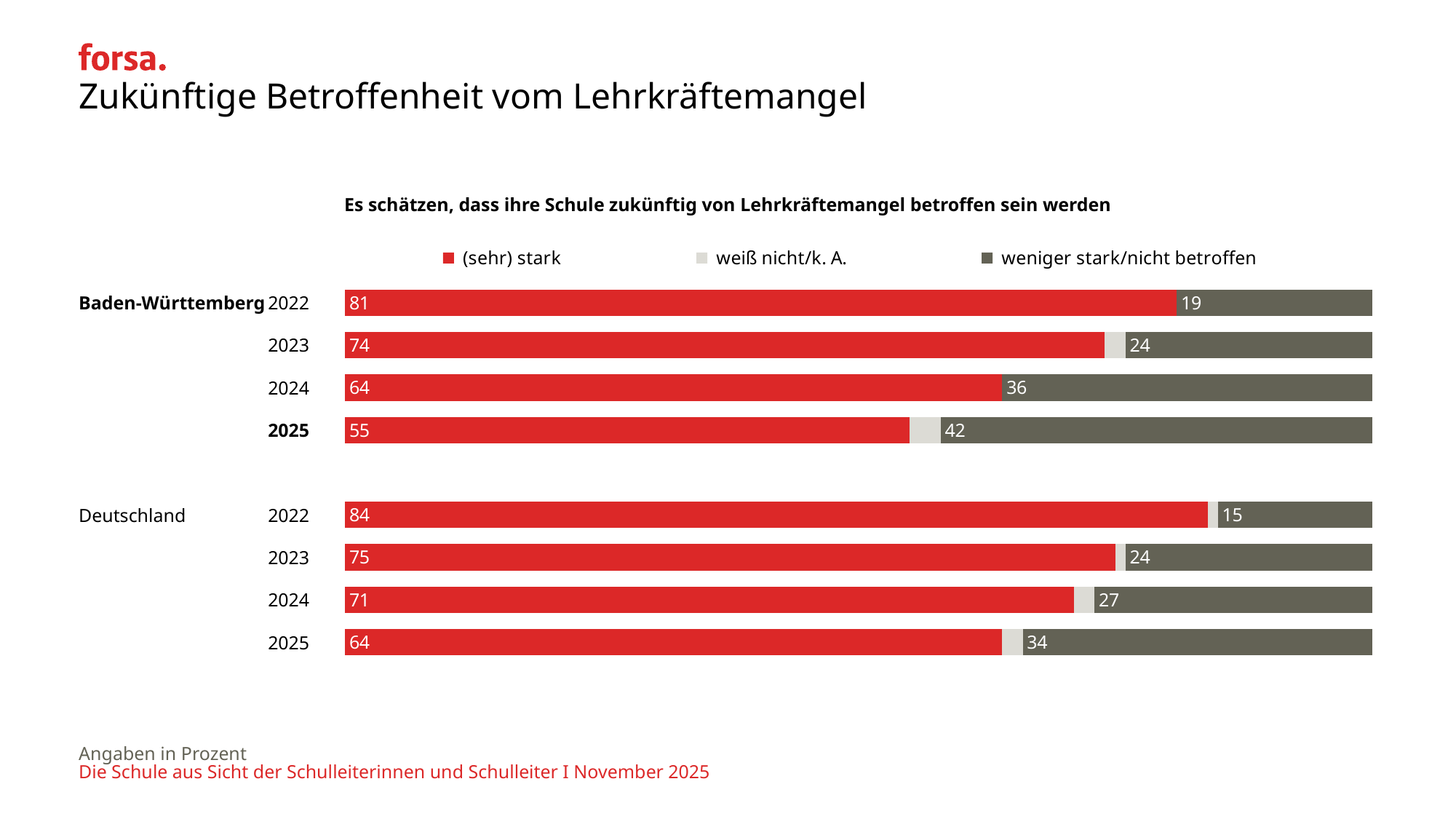
Which is larger: the "(sehr) stark" value for Baden-Württemberg in 2024 or for Deutschland in 2024? Deutschland 2024 What is the value for "(sehr) stark" for Deutschland in 2022? 84 Which year has the lowest "(sehr) stark" value for Deutschland? 2025 How do the "(sehr) stark" values for Deutschland change from 2022 to 2025? They fall Which series is shown in red in the chart? (sehr) stark What is the value for "(sehr) stark" for Baden-Württemberg in 2025? 55 What is the difference between the "(sehr) stark" values for Baden-Württemberg in 2022 and 2025? 26 What kind of chart is shown on the slide? Stacked bar chart How many series does the legend list? 3 Which year has the highest "(sehr) stark" value for Baden-Württemberg? 2022 How many bars are shown in the chart in total? 8 What is the value for "weniger stark/nicht betroffen" for Deutschland in 2024? 27